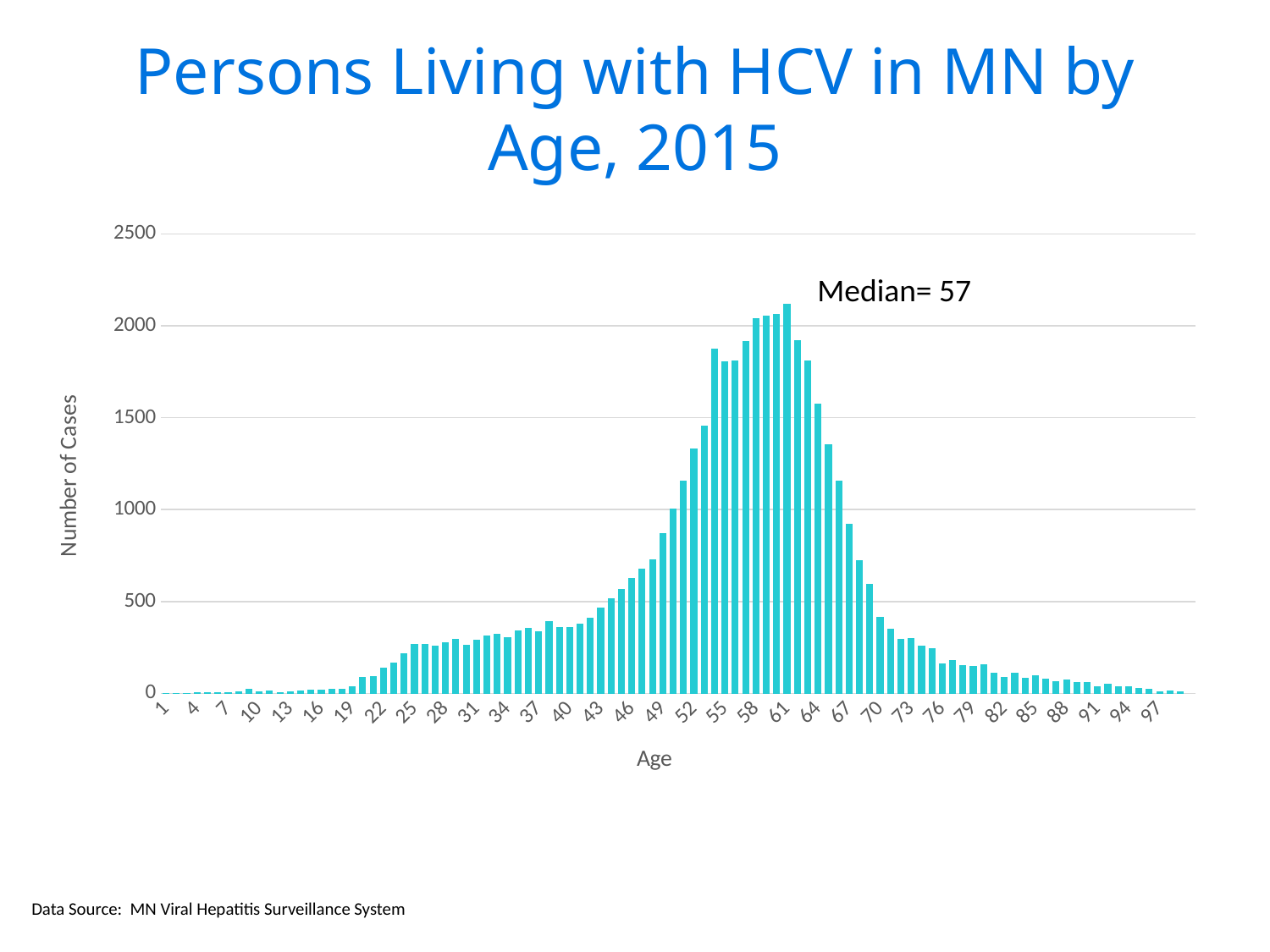
Is the number of cases for age 70 greater or less than 1000? less Is the number of cases for age 46 greater or less than 500? greater What is the title of the chart? Persons Living with HCV in MN by Age, 2015 What median value is annotated on the chart? Median= 57 Is the number of cases for age 55 greater or less than 1500? greater Do the number of cases rise or fall as age increases from 64 to 85? fall What kind of chart is shown on the slide? Bar chart Do the number of cases rise or fall as age increases from 40 to 55? rise Which age has more cases, 52 or 76? 52